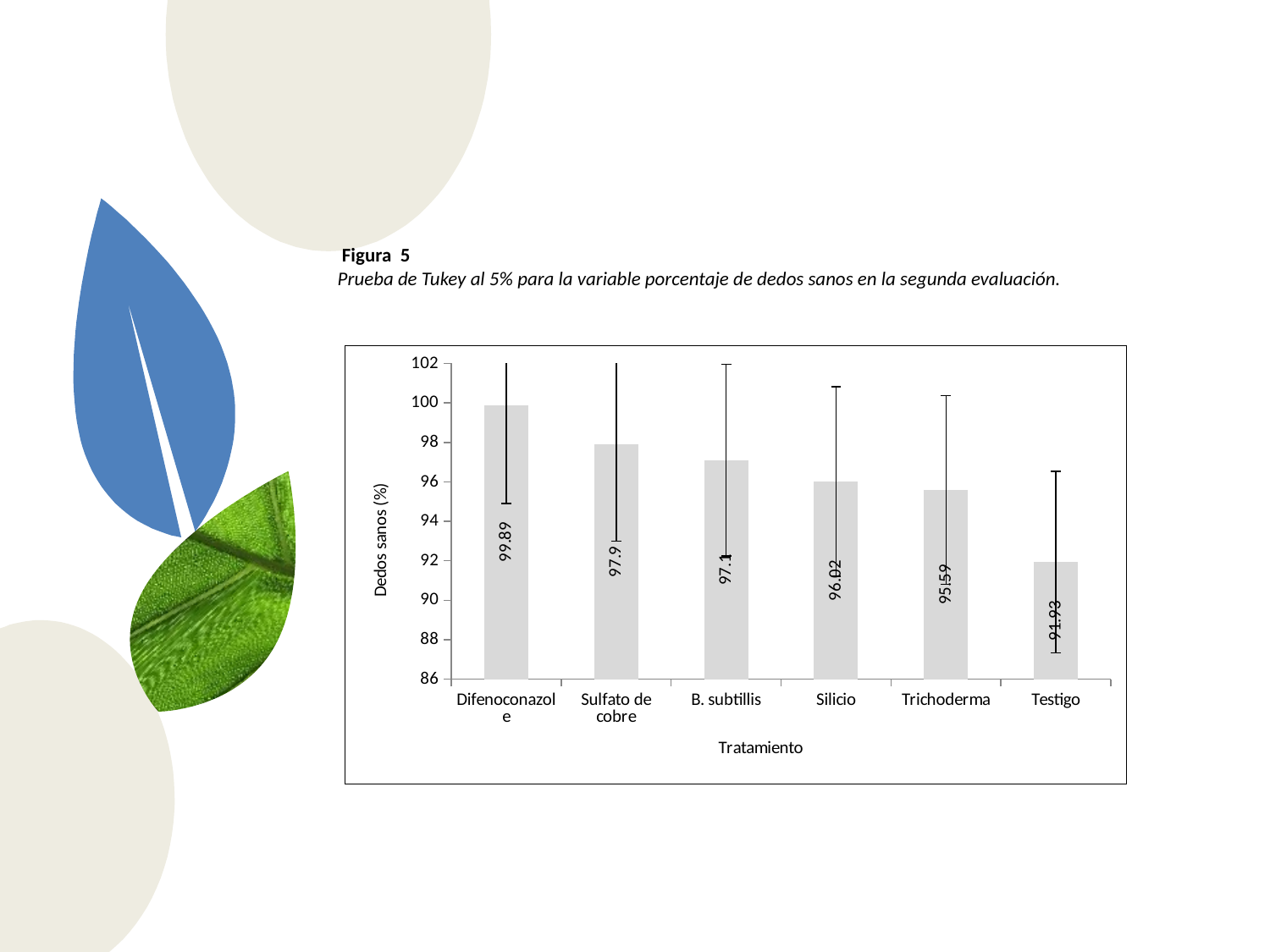
How many treatments are shown on the x axis? 6 Which treatment has the highest percentage of healthy fingers (dedos sanos)? Difenoconazole Is the value for Testigo greater or less than 94? less What is the difference between the values for Difenoconazole and Testigo? 7.96 Which treatment has the lowest percentage of healthy fingers (dedos sanos)? Testigo What kind of chart is shown on the slide? Bar chart What is the label of the y axis? Dedos sanos (%) What is the value for Silicio? 96.02 Which is larger, the value for B. subtillis or the value for Silicio? B. subtillis What is the value for Trichoderma? 95.59 What is the value for Difenoconazole? 99.89 What is the value for Sulfato de cobre? 97.9